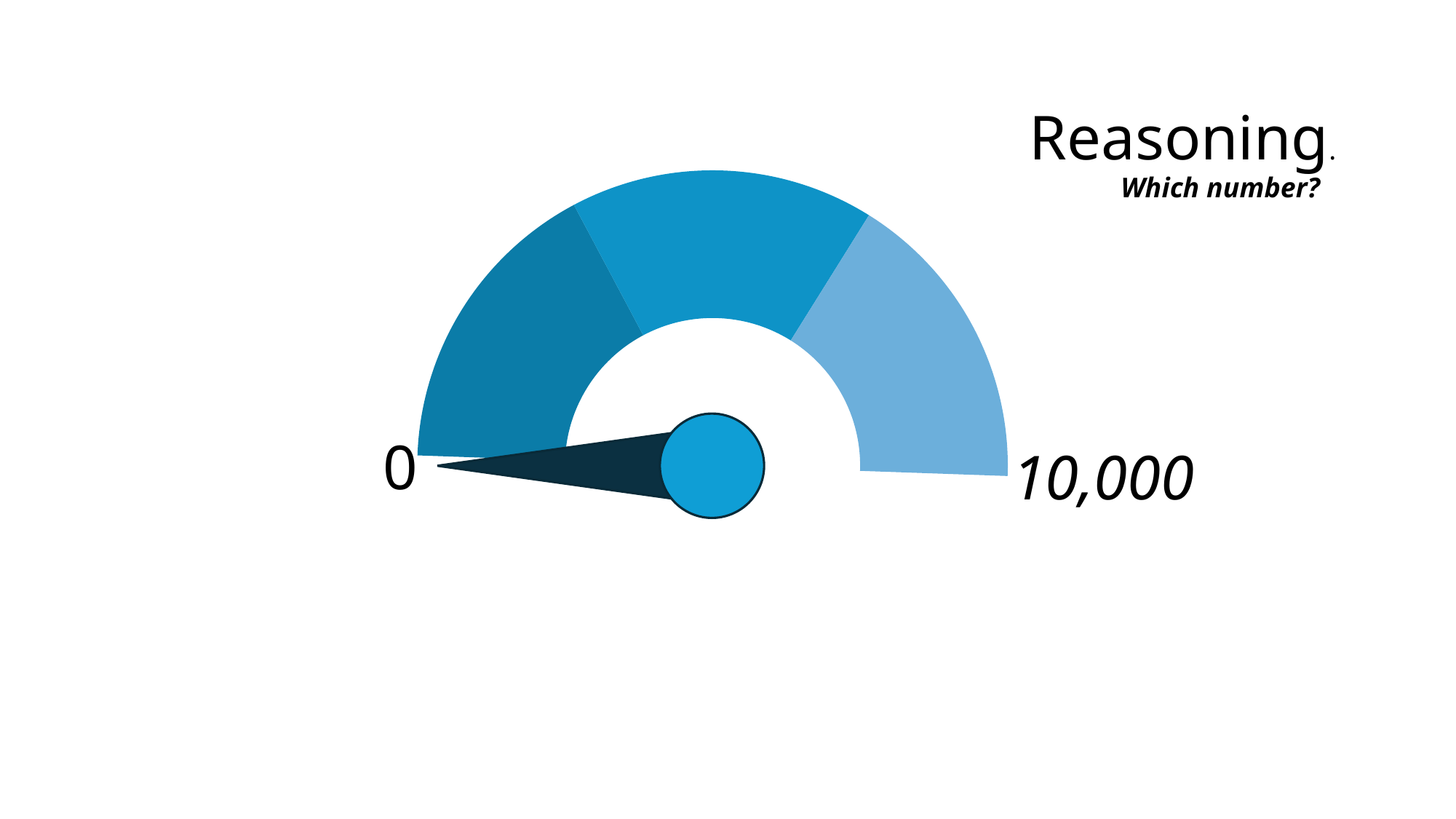
What is the highest value labelled on the gauge? 10,000 Is the needle value greater or less than 10,000? less What value does the needle point to on the gauge? 0 What subtitle appears under the title? Which number? What is the lowest value labelled on the gauge? 0 What is the title shown on the slide? Reasoning. How many coloured segments does the gauge arc have? 3 What kind of chart is shown on the slide? gauge chart